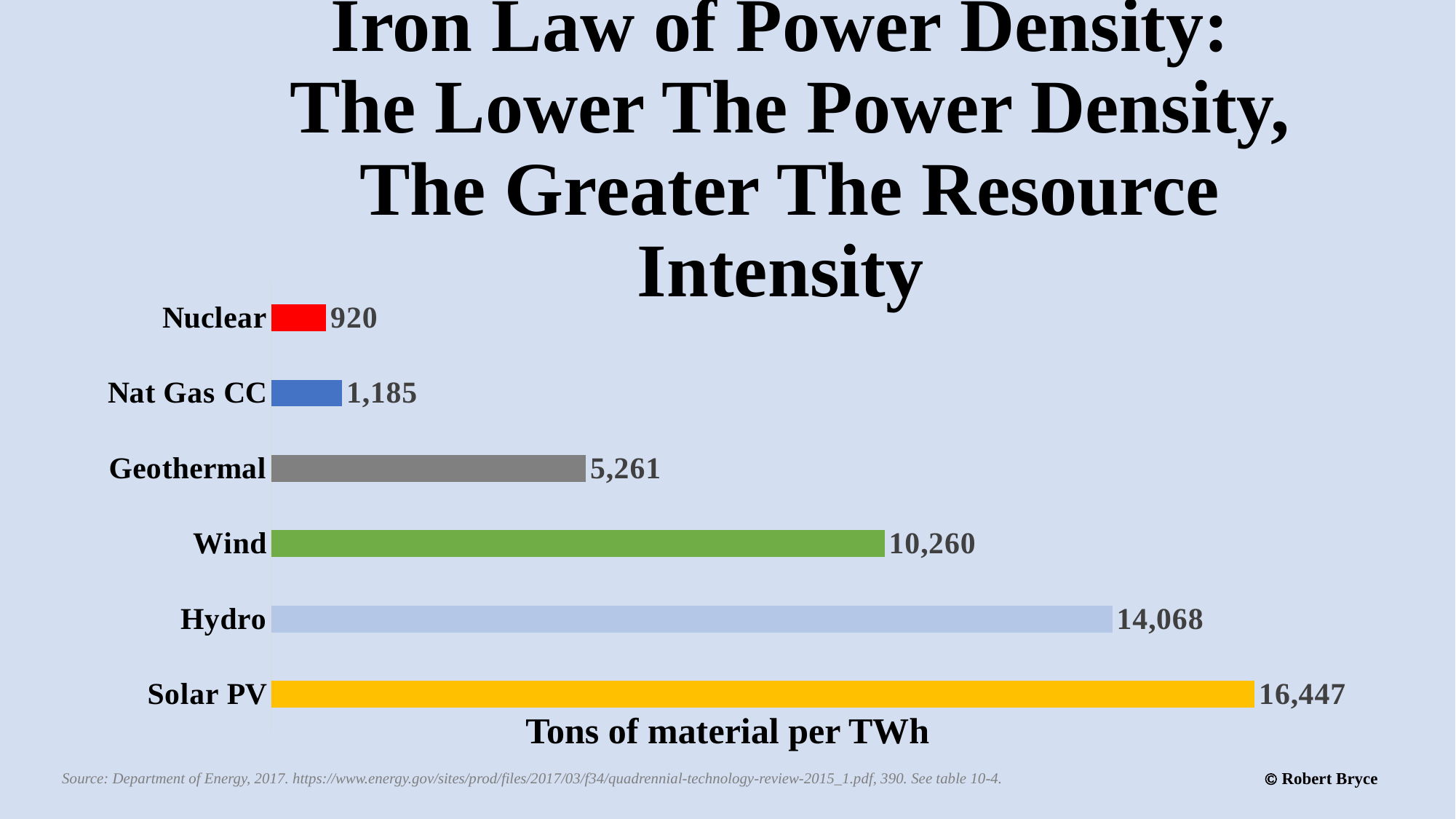
Which energy source has the lowest tons of material per TWh? Nuclear What is the value for Wind in tons of material per TWh? 10,260 How many energy sources are shown in the chart? 6 What is the value for Nuclear in tons of material per TWh? 920 What is the difference between the values for Solar PV and Hydro? 2,379 What colour is the bar for Nuclear? Red Which energy source has the highest tons of material per TWh? Solar PV What kind of chart is shown on the slide? Bar chart What is the value for Geothermal in tons of material per TWh? 5,261 What is the value for Hydro in tons of material per TWh? 14,068 Which has a larger value, Wind or Geothermal? Wind What is the difference between the values for Nat Gas CC and Nuclear? 265